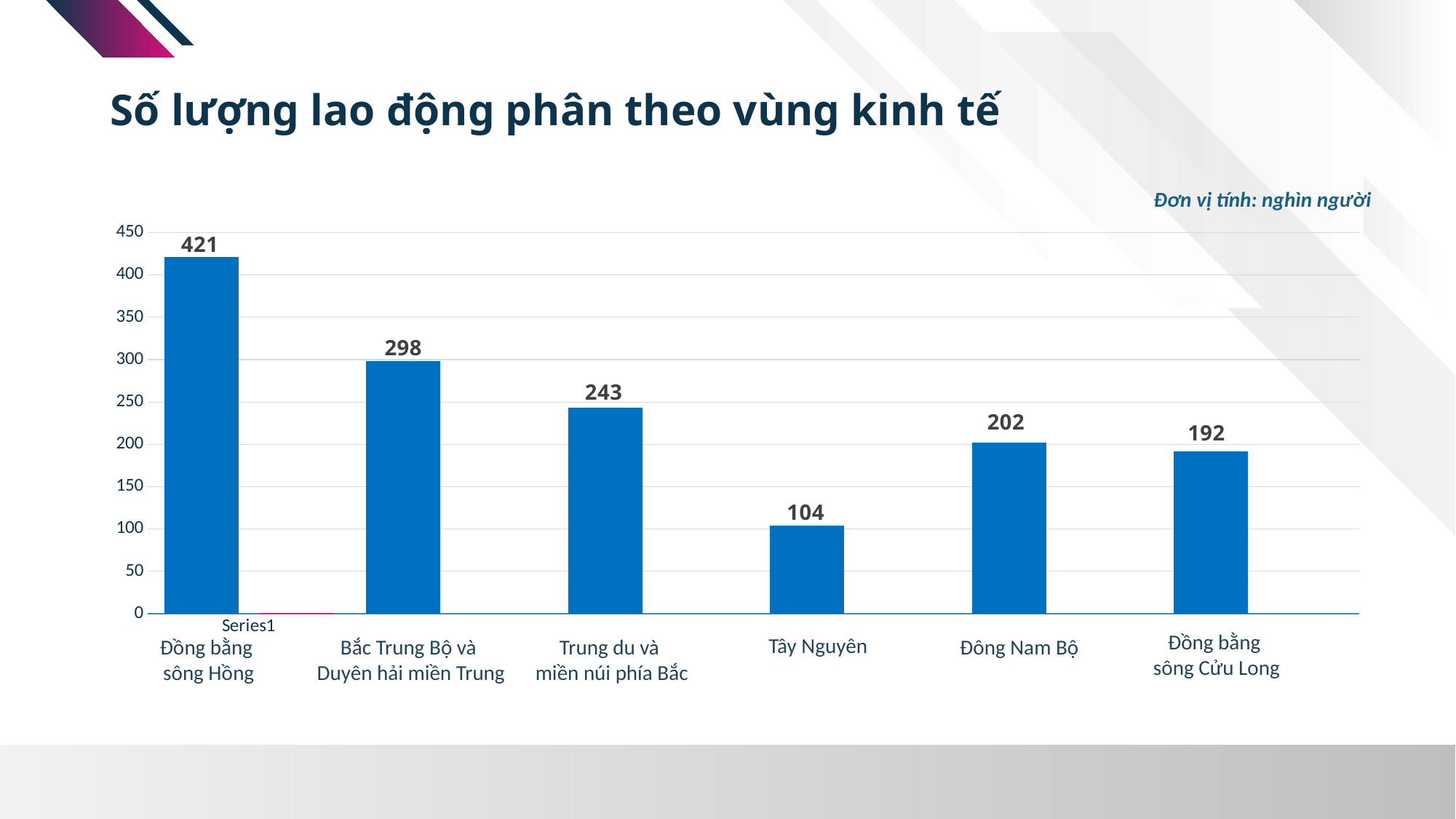
What is the difference between the values for Đồng bằng sông Hồng and Bắc Trung Bộ và Duyên hải miền Trung? 123 What is the value for Đồng bằng sông Hồng? 421 Which is larger, the value for Trung du và miền núi phía Bắc or the value for Đông Nam Bộ? Trung du và miền núi phía Bắc Is the value for Bắc Trung Bộ và Duyên hải miền Trung greater or less than 250? greater How many regions are shown on the x axis? 6 Which region has the lowest value? Tây Nguyên What is the value for Đồng bằng sông Cửu Long? 192 What is the difference between the values for Đông Nam Bộ and Đồng bằng sông Cửu Long? 10 Which region has the highest value? Đồng bằng sông Hồng What is the value for Tây Nguyên? 104 What kind of chart is shown on the slide? bar chart What unit of measurement is stated on the slide? nghìn người